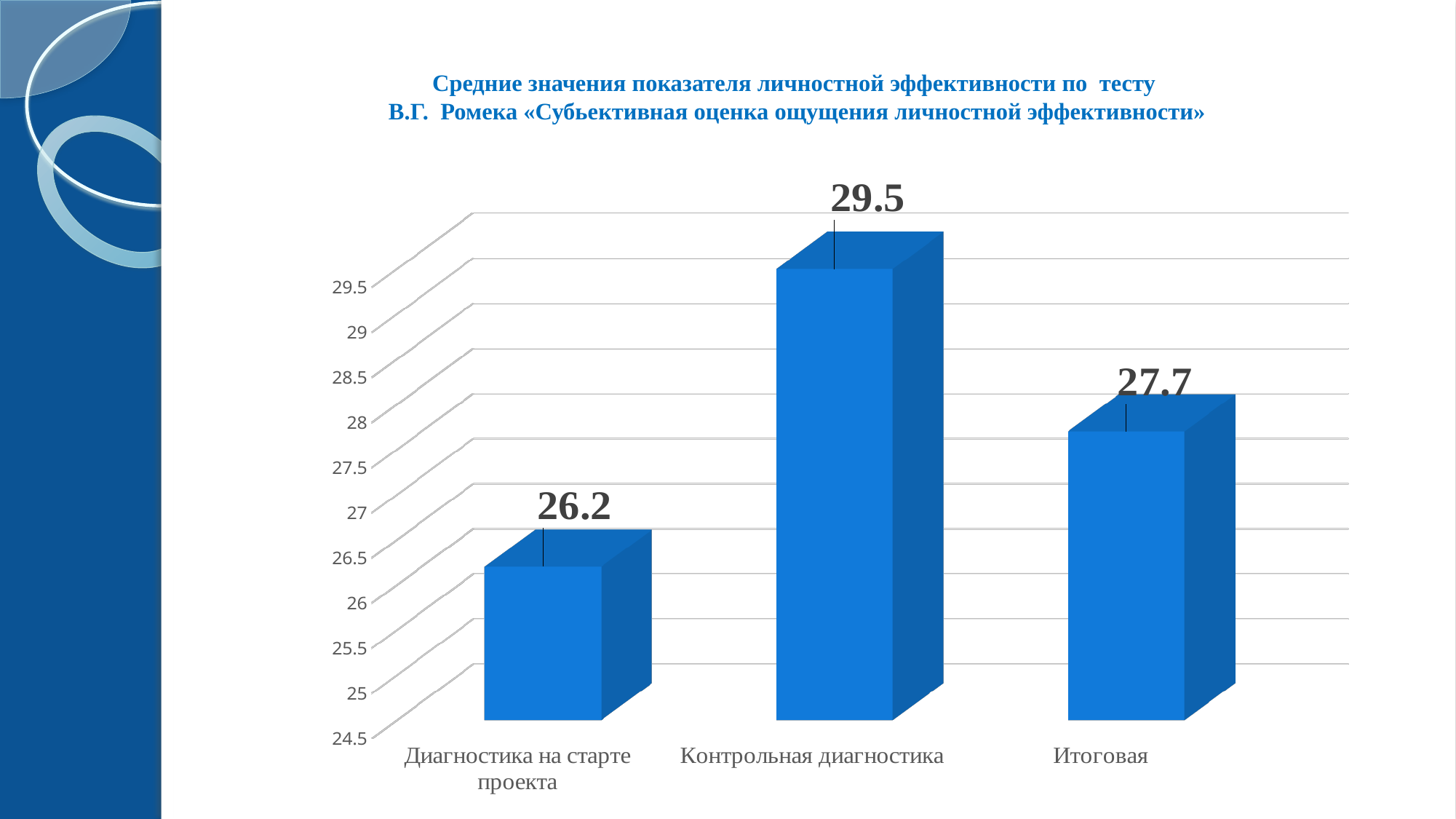
What is the value for Итоговая? 27.7 What is the value for Диагностика на старте проекта? 26.2 How many categories are shown on the chart? 3 Which category has the lowest value? Диагностика на старте проекта What is the difference between the values for Контрольная диагностика and Итоговая? 1.8 Which category has the highest value? Контрольная диагностика Is the value for Итоговая greater or less than 28? less Which is larger, the value for Итоговая or the value for Диагностика на старте проекта? Итоговая What kind of chart is shown on the slide? bar chart What is the lowest value shown on the vertical axis? 24.5 What is the difference between the values for Контрольная диагностика and Диагностика на старте проекта? 3.3 What is the value for Контрольная диагностика? 29.5